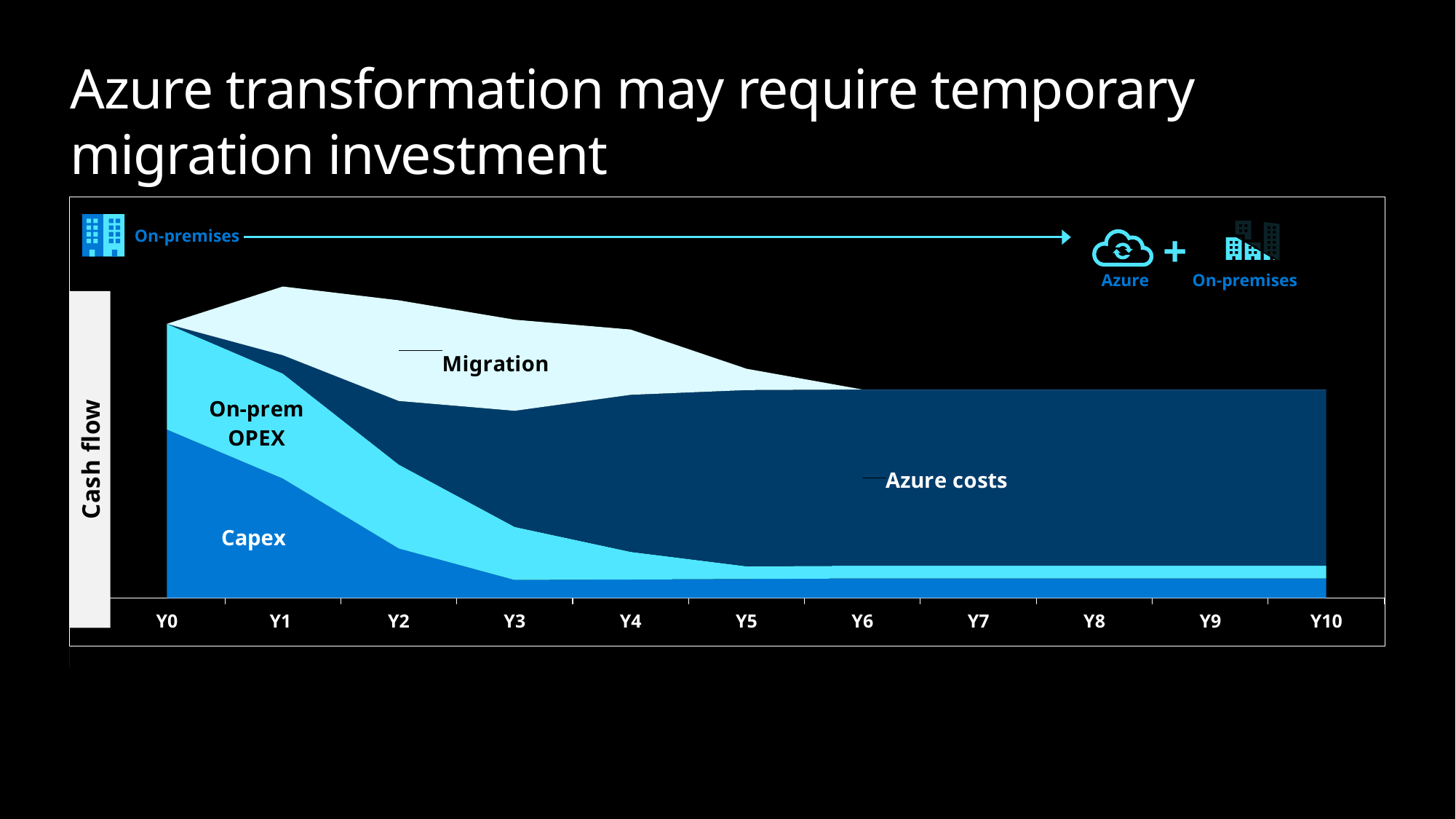
Which series is the largest at Y10? Azure costs What kind of chart is shown on the slide? Area chart Does the Azure costs area rise or fall from Y0 to Y6? Rise What is the first category on the x axis? Y0 Does the Capex area rise or fall from Y0 to Y10? Fall How many series (areas) are labelled in the chart? 4 Which series is the largest at Y0? Capex At Y0, which is larger: Capex or On-prem OPEX? Capex How many points are labelled along the x axis of the chart? 11 At Y8, which is larger: Azure costs or Capex? Azure costs What is the label of the vertical axis? Cash flow Does the On-prem OPEX area rise or fall from Y0 to Y5? Fall